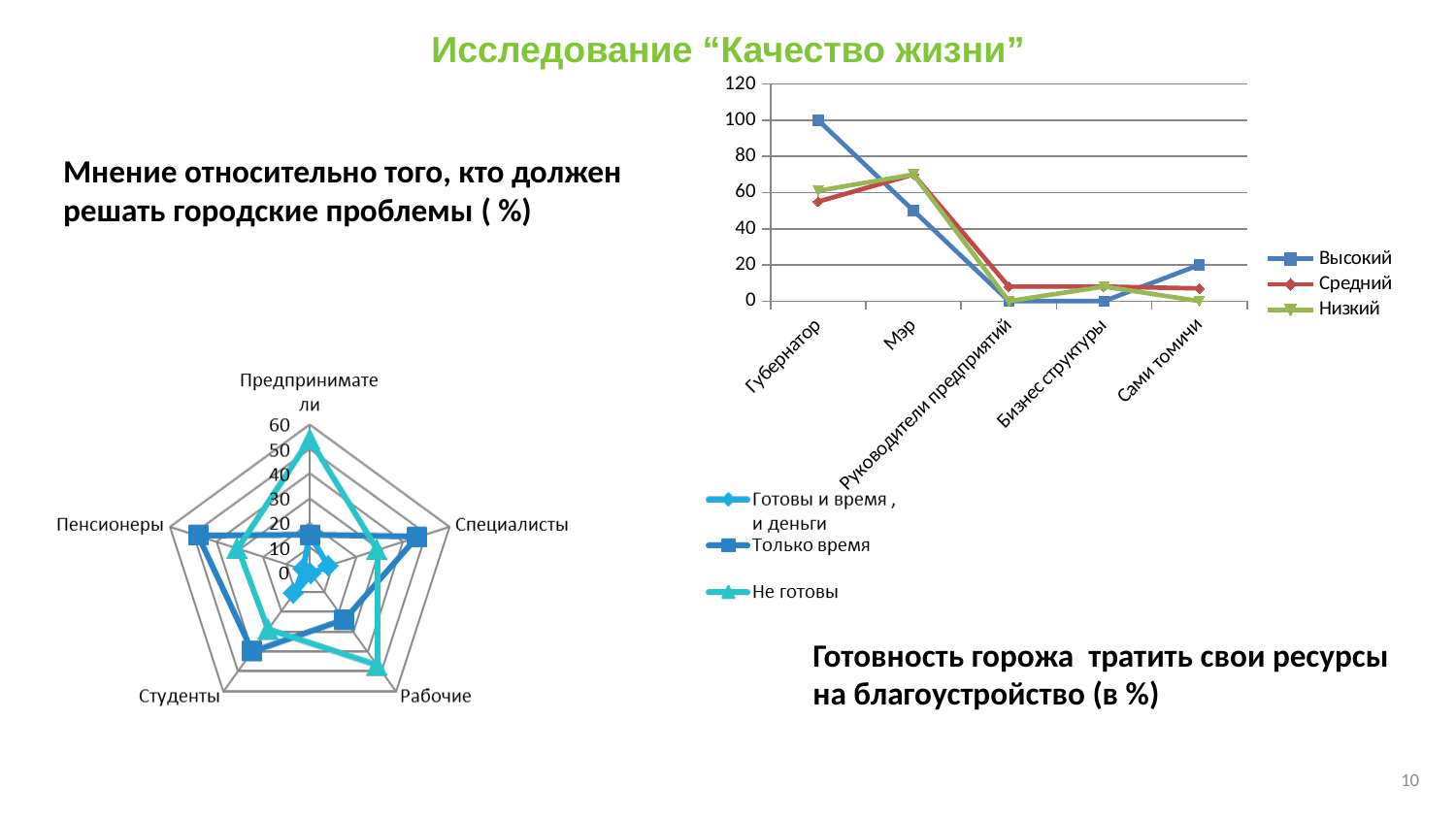
What kind of chart is the chart titled "Мнение относительно того, кто должен решать городские проблемы (%)"? Line chart In the chart "Готовность горожа тратить свои ресурсы на благоустройство (в %)", how many categories are shown on the radar axes? 5 In the chart "Мнение относительно того, кто должен решать городские проблемы (%)", is the value of the Средний series for Мэр greater or less than 60? greater In the chart "Готовность горожа тратить свои ресурсы на благоустройство (в %)", how many series does the legend list? 3 In the chart "Мнение относительно того, кто должен решать городские проблемы (%)", for Губернатор, which series has the larger value: Высокий or Средний? Высокий In the chart "Мнение относительно того, кто должен решать городские проблемы (%)", which category has the highest value for the Высокий series? Губернатор In the chart "Мнение относительно того, кто должен решать городские проблемы (%)", does the Высокий series rise or fall from Губернатор to Бизнес структуры? Fall In the chart "Мнение относительно того, кто должен решать городские проблемы (%)", how many categories are on the x axis? 5 What kind of chart is the chart titled "Готовность горожа тратить свои ресурсы на благоустройство (в %)"? Radar chart In the chart "Мнение относительно того, кто должен решать городские проблемы (%)", how many series does the legend list? 3 In the chart "Мнение относительно того, кто должен решать городские проблемы (%)", what is the value of the Высокий series for Сами томичи? 20 In the chart "Мнение относительно того, кто должен решать городские проблемы (%)", what is the value of the Высокий series for Губернатор? 100